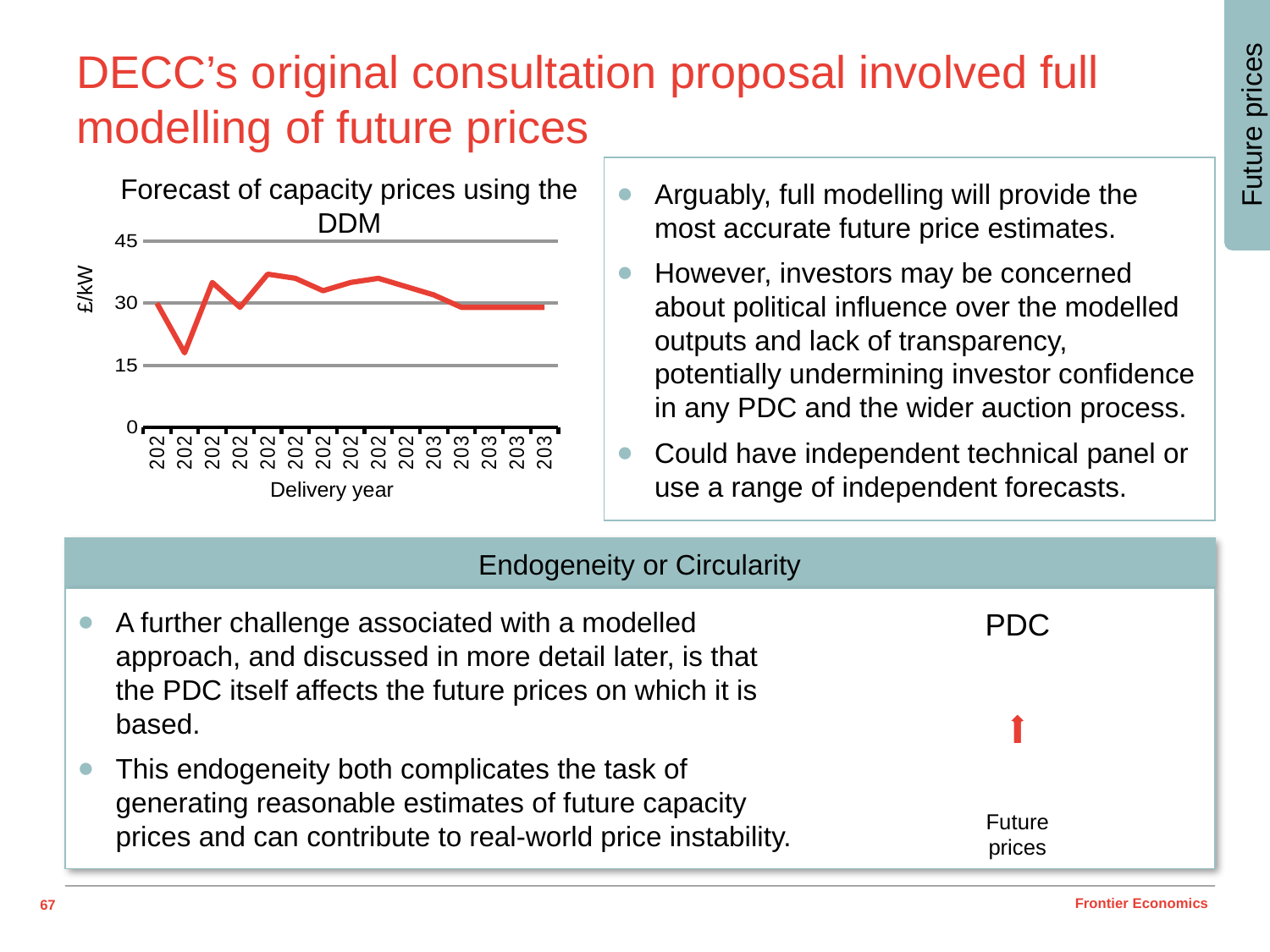
What unit is shown on the y-axis of the chart? £/kW What is the title of the chart on the slide? Forecast of capacity prices using the DDM How many data points are plotted on the line in the chart? 15 Does the line rise or fall over the last three delivery years? it stays flat Is the highest point on the line greater or less than 45? less Is the lowest point on the line greater or less than 30? less Is the lowest point on the line greater or less than 15? greater Does the line rise or fall between the first and second delivery years? fall What kind of chart is shown on the slide? line chart Which point on the line is the lowest: the second point or the last point? the second point How many series are plotted in the chart? 1